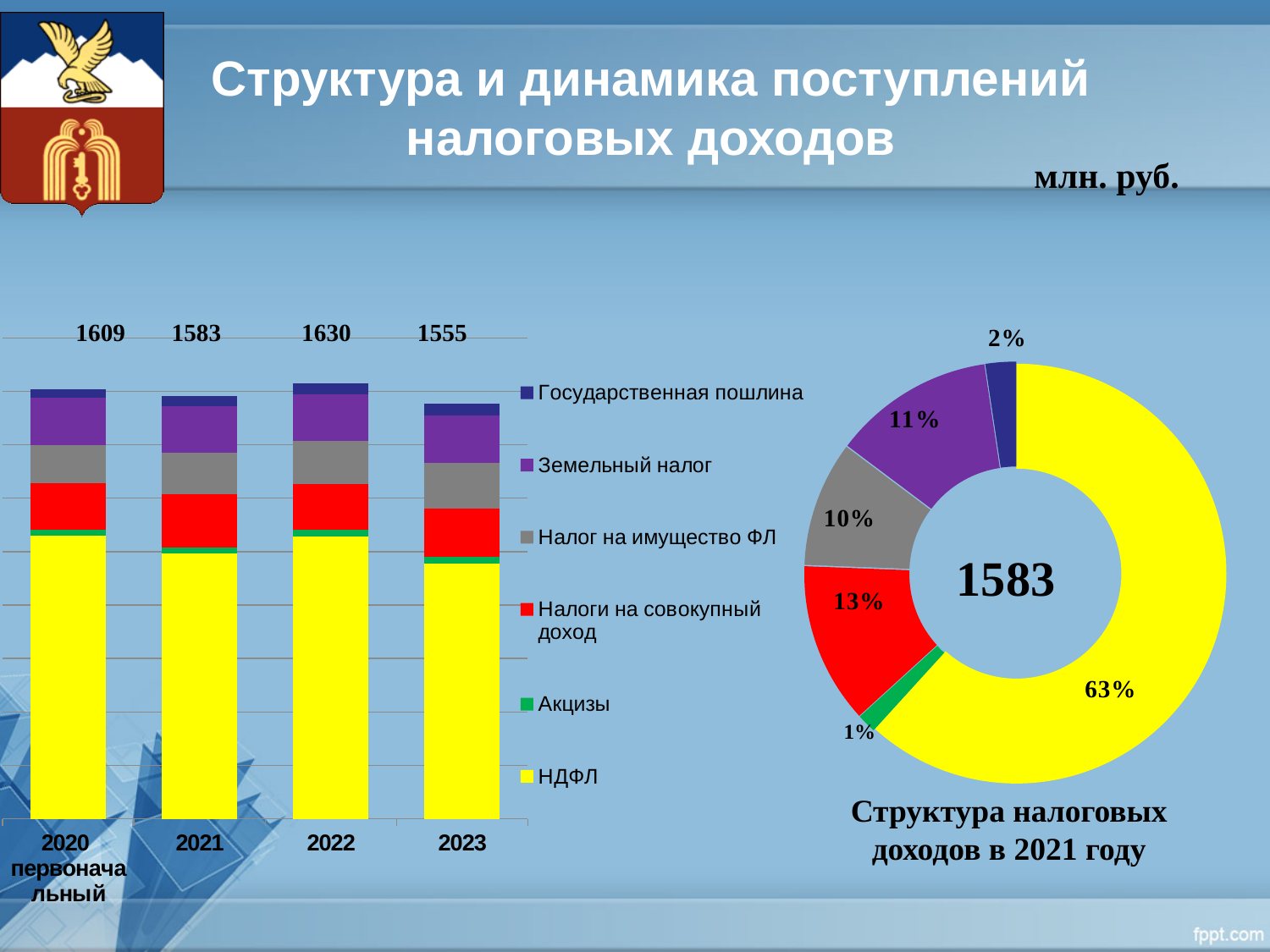
In the stacked bar chart on the left, which year has the lowest total tax revenue? 2023 In the chart titled 'Структура налоговых доходов в 2021 году', what share does the red slice (Налоги на совокупный доход) have? 13% How many bars are shown in the stacked bar chart on the left? 4 In the stacked bar chart on the left, which total is larger: 2020 первоначальный or 2021? 2020 первоначальный How many series does the legend of the stacked bar chart on the left list? 6 In the stacked bar chart on the left, what is the total shown above the 2023 bar? 1555 In the stacked bar chart on the left, what is the total tax revenue shown for 2022? 1630 In the stacked bar chart on the left, which year has the highest total tax revenue? 2022 In the chart titled 'Структура налоговых доходов в 2021 году', what total value is printed in the centre of the doughnut? 1583 In the stacked bar chart on the left, what is the difference between the totals for 2022 and 2023? 75 In the chart titled 'Структура налоговых доходов в 2021 году', what share does the largest slice (НДФЛ, yellow) have? 63% What kind of chart is the one titled 'Структура налоговых доходов в 2021 году'? Doughnut (pie) chart